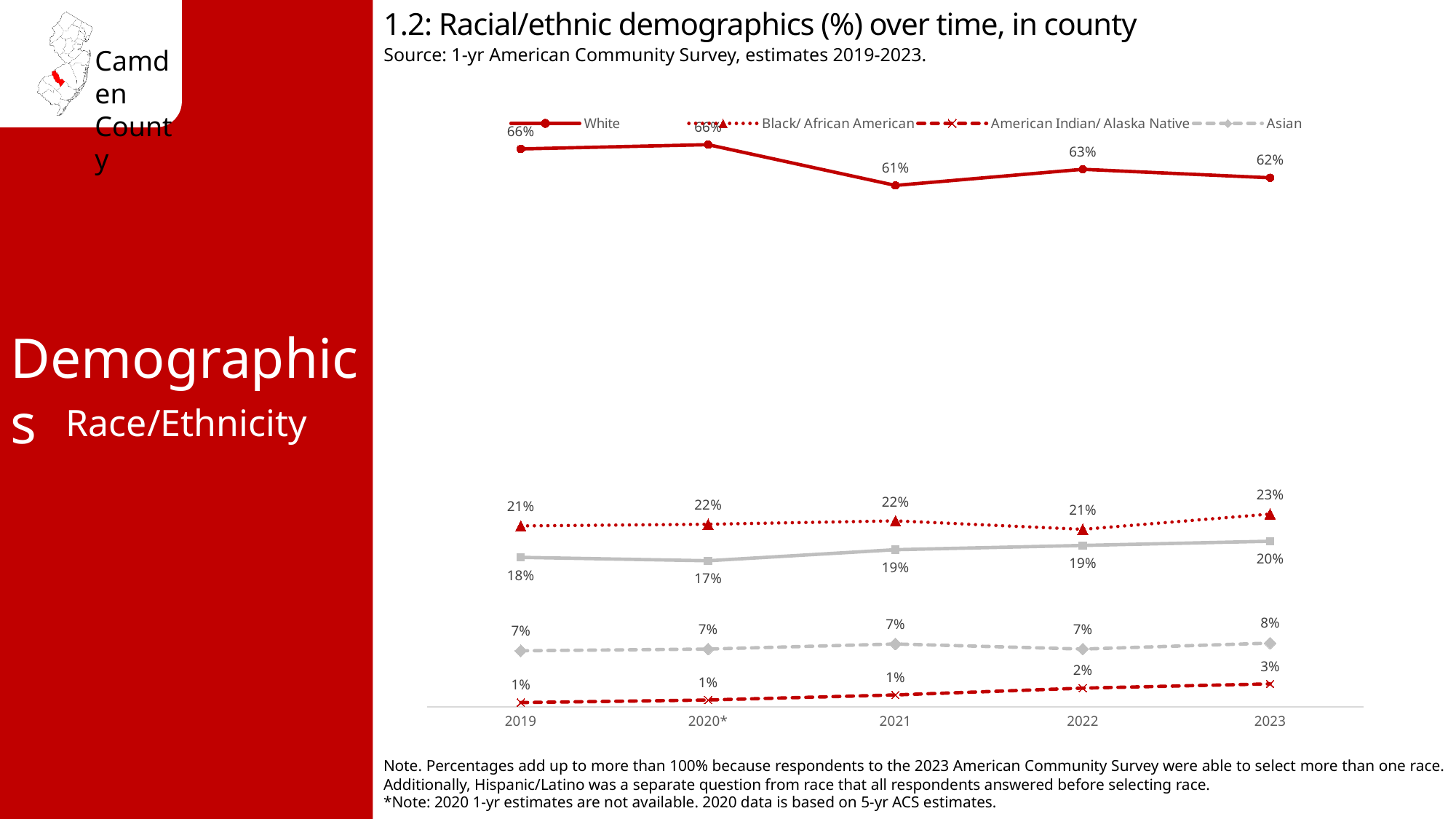
What was the Asian percentage in 2023? 8% What was the White percentage in 2021? 61% How many years are shown on the x axis? 5 What is the source cited for the chart? 1-yr American Community Survey, estimates 2019-2023 What was the American Indian/ Alaska Native percentage in 2022? 2% Which is larger in 2023, the Asian percentage or the American Indian/ Alaska Native percentage? Asian What is the difference between the White percentage in 2019 and in 2023? 4% In which year was the Black/ African American percentage highest? 2023 Did the American Indian/ Alaska Native percentage rise or fall from 2019 to 2023? rise In which year was the White percentage lowest? 2021 What was the Black/ African American percentage in 2023? 23% What type of chart is shown on the slide? line chart